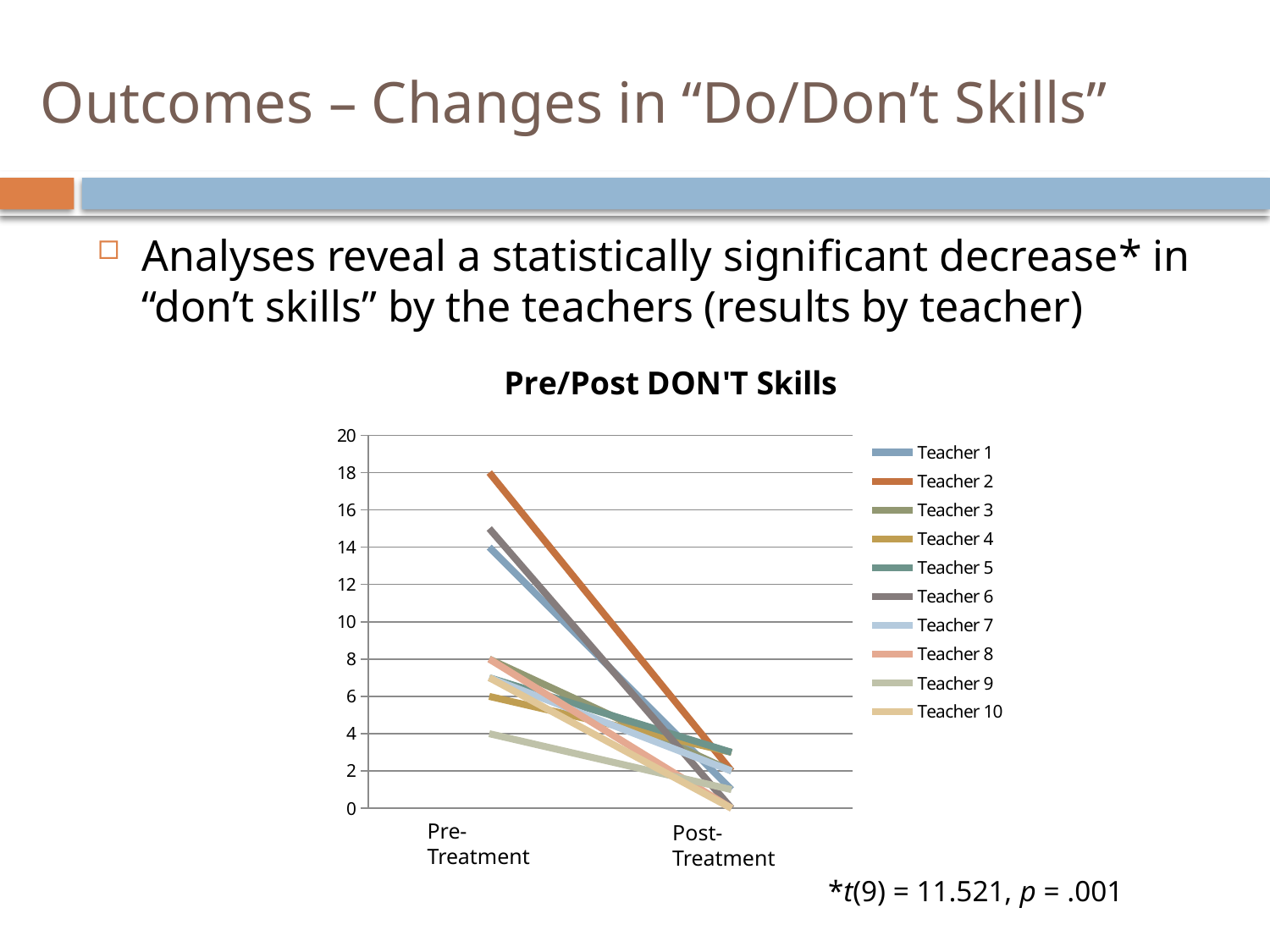
Is the Post-Treatment value for Teacher 2 greater or less than 4? less Do the values rise or fall from Pre-Treatment to Post-Treatment? fall What is the title of the chart? Pre/Post DON'T Skills Which teacher has the lowest Pre-Treatment value? Teacher 9 How many series does the legend list? 10 What kind of chart is shown on the slide? line chart How many categories are shown on the x axis? 2 At Pre-Treatment, which is larger: Teacher 2 or Teacher 1? Teacher 2 Which teacher has the highest Pre-Treatment value? Teacher 2 Is the Pre-Treatment value for Teacher 2 greater or less than 16? greater At Pre-Treatment, which is larger: Teacher 8 or Teacher 9? Teacher 8 Is the Pre-Treatment value for Teacher 9 greater or less than 6? less